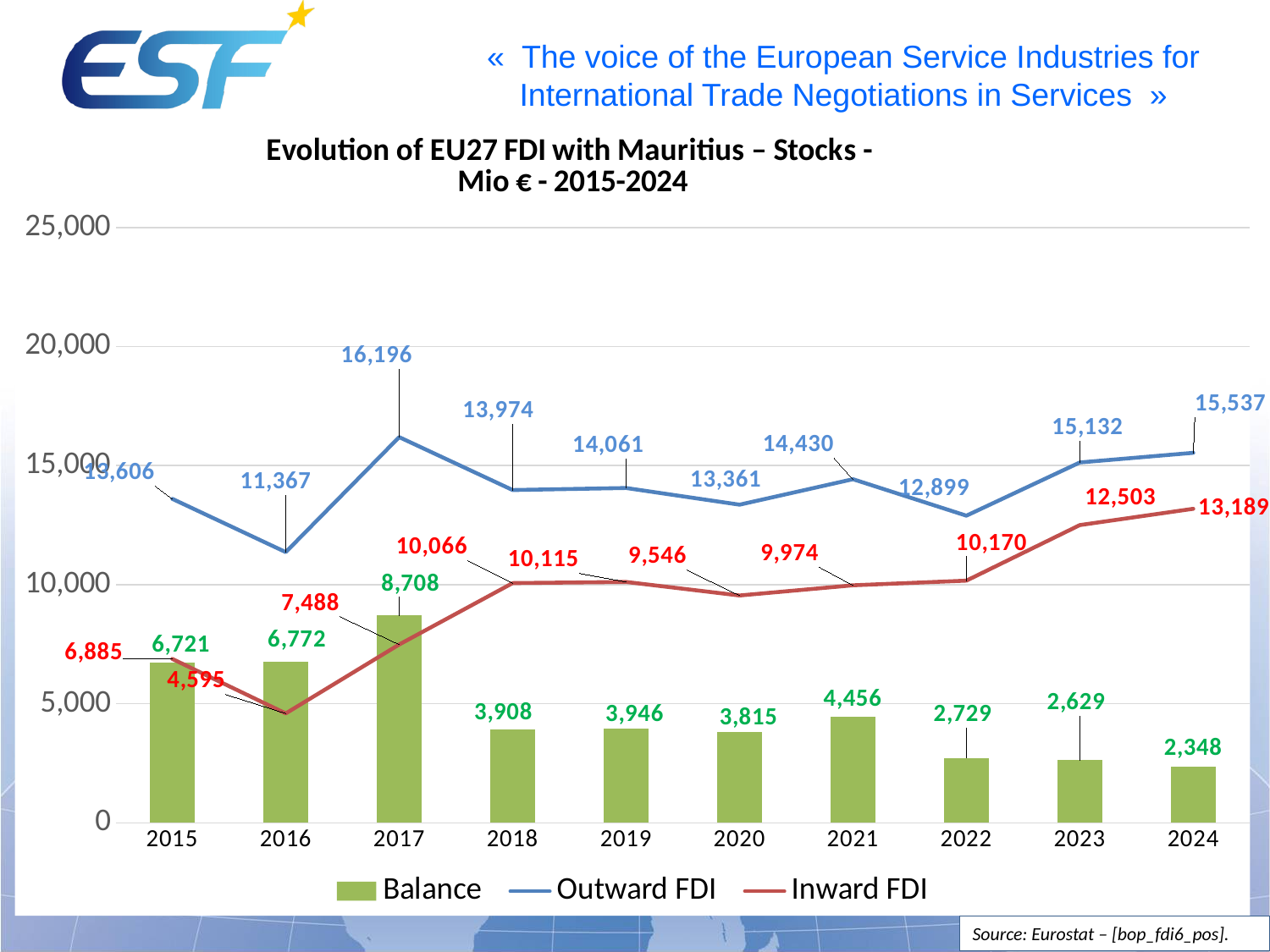
In which year is Inward FDI lowest? 2016 Does Inward FDI rise or fall from 2020 to 2024? rise Which year has the larger Balance, 2016 or 2017? 2017 What is the Inward FDI value for 2024? 13,189 In which year is the Balance lowest? 2024 Is the Inward FDI value for 2023 greater or less than 10,000? greater What is the difference between Outward FDI and Inward FDI in 2024? 2,348 In which year is Outward FDI highest? 2017 What is the Balance value for 2022? 2,729 How many years are shown on the x axis? 10 How many series does the legend list? 3 What is the Outward FDI value for 2017? 16,196